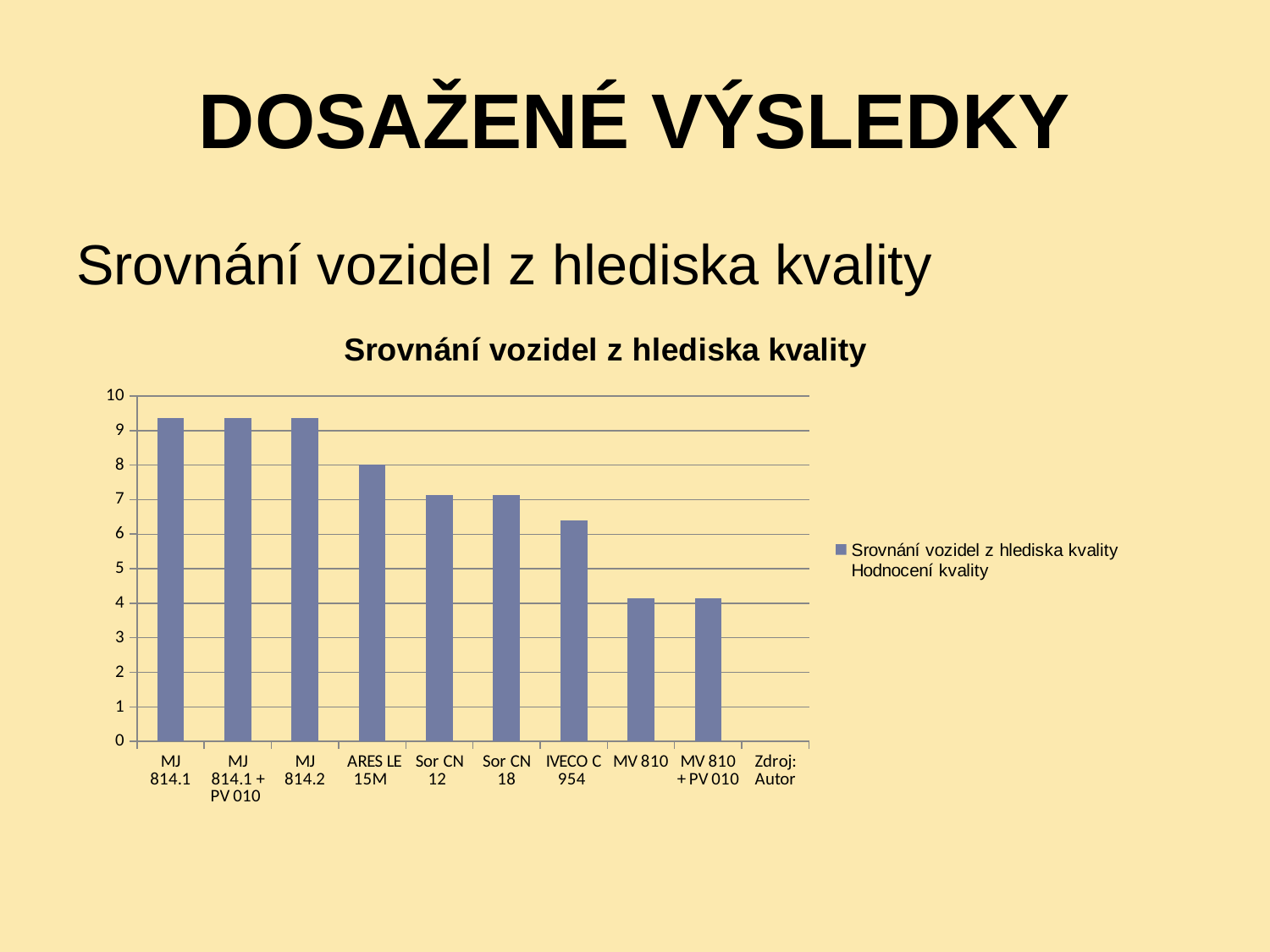
Is the value for MV 810 greater or less than 5? less How many series does the legend list? 1 Which has the larger value, MJ 814.2 or IVECO C 954? MJ 814.2 How many bars are plotted in the chart? 9 What is the last label shown on the x axis of the chart? Zdroj: Autor What is the title of the chart? Srovnání vozidel z hlediska kvality Which has the larger value, ARES LE 15M or Sor CN 18? ARES LE 15M Is the value for MJ 814.1 greater or less than 9? greater Do the bar values generally rise or fall from left to right along the x axis? fall What kind of chart is shown on the slide? bar chart Is the value for IVECO C 954 greater or less than 6? greater